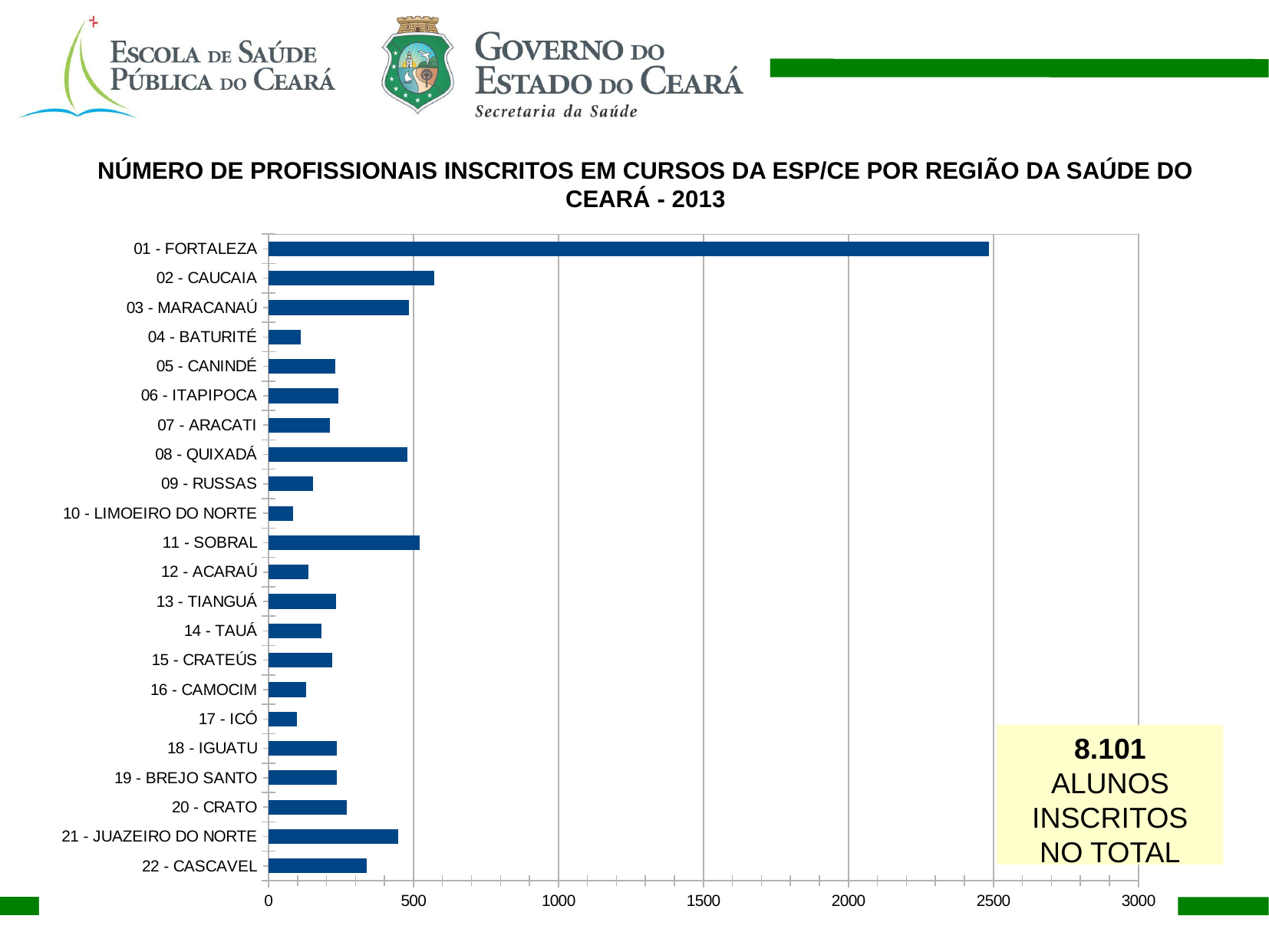
What kind of chart is shown on the slide? bar chart Which health region has the highest number of professionals enrolled? 01 - FORTALEZA Which has a larger value, 02 - CAUCAIA or 03 - MARACANAÚ? 02 - CAUCAIA Is the value for 02 - CAUCAIA greater or less than 500? greater Is the value for 22 - CASCAVEL greater or less than 500? less What year does the chart title refer to? 2013 Which has a larger value, 21 - JUAZEIRO DO NORTE or 22 - CASCAVEL? 21 - JUAZEIRO DO NORTE According to the text box on the slide, how many students were enrolled in total? 8.101 Is the value for 01 - FORTALEZA greater or less than 2000? greater How many health regions (categories) are plotted in the chart? 22